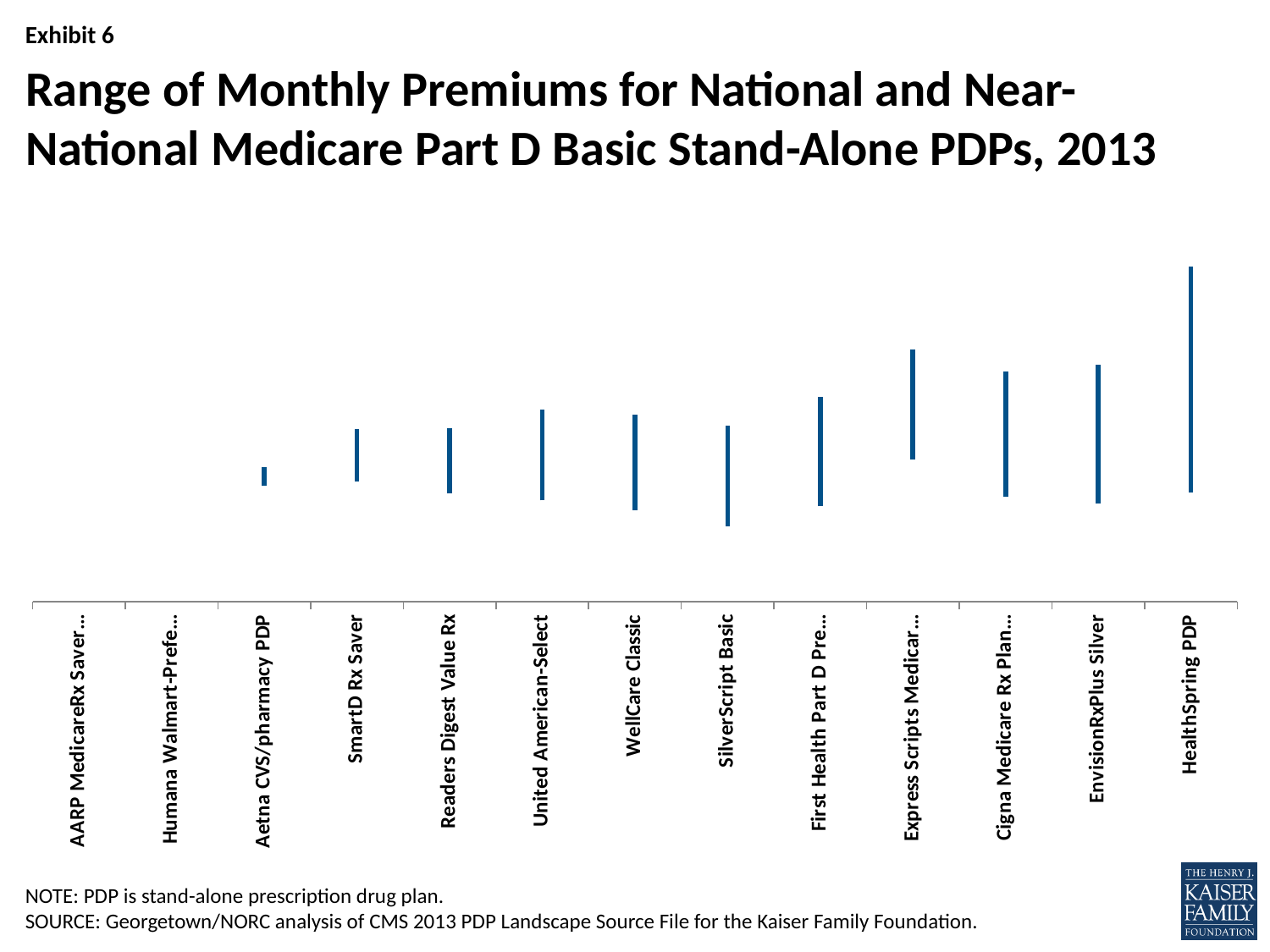
Do the tops of the premium ranges generally rise or fall moving from left to right across the chart? rise Which plan's range reaches higher: Express Scripts Medicare or WellCare Classic? Express Scripts Medicare Which plan's premium range reaches the highest point on the chart? HealthSpring PDP Which plan has the narrowest range of monthly premiums shown? Aetna CVS/pharmacy PDP Which plan's premium range extends to the lowest point on the chart? SilverScript Basic What is the title of the chart? Range of Monthly Premiums for National and Near-National Medicare Part D Basic Stand-Alone PDPs, 2013 Which plan is listed first on the x axis of the chart? AARP MedicareRx Saver Which plan has the widest range of monthly premiums shown? HealthSpring PDP What colour are the range lines plotted on the chart? blue Which plan's range has the lower bottom: SilverScript Basic or SmartD Rx Saver? SilverScript Basic Which plan's range reaches higher: HealthSpring PDP or Cigna Medicare Rx Plan? HealthSpring PDP How many plans are listed along the x axis of the chart? 13